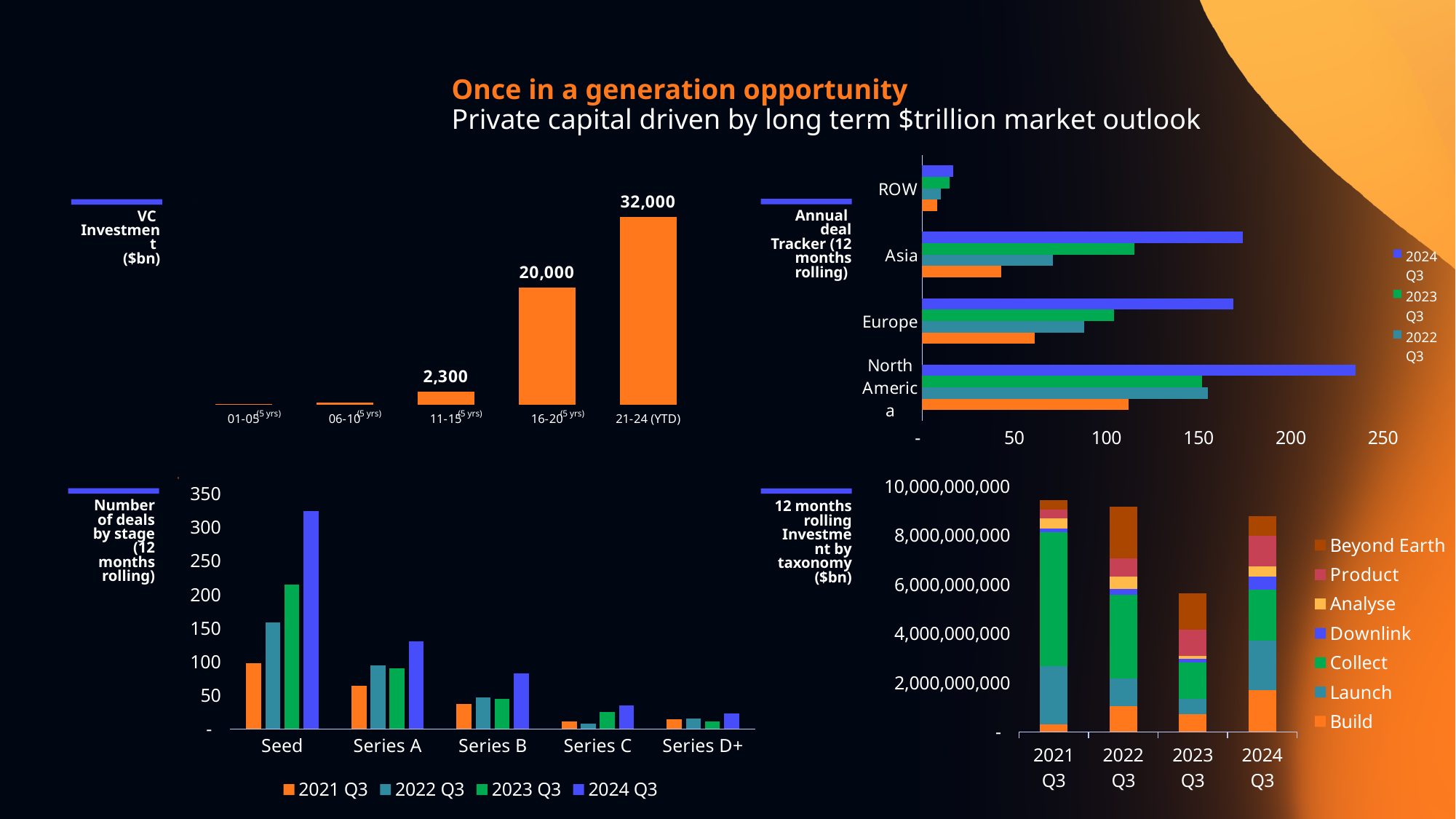
How many series does the legend of the 12 months rolling Investment by taxonomy chart list? 7 In the Annual deal Tracker chart, is the 2024 Q3 value for ROW greater or less than 50? less In the VC Investment ($bn) chart, what is the value for 16-20 (5 yrs)? 20,000 In the VC Investment ($bn) chart, what is the value for 21-24 (YTD)? 32,000 In the VC Investment ($bn) chart, what is the difference between the 21-24 (YTD) and 16-20 (5 yrs) values? 12,000 In the 12 months rolling Investment by taxonomy chart, which period has the shortest stacked bar? 2023 Q3 In the Number of deals by stage chart, which stage has the highest 2024 Q3 value? Seed In the Annual deal Tracker chart, is the 2024 Q3 value for North America greater or less than 200? greater In the Number of deals by stage chart, is the 2024 Q3 value for Seed greater or less than 300? greater In the VC Investment ($bn) chart, which period has the highest value? 21-24 (YTD) In the VC Investment ($bn) chart, do the values rise or fall from left to right along the x axis? rise In the Annual deal Tracker chart, which region has the longest 2024 Q3 bar? North America